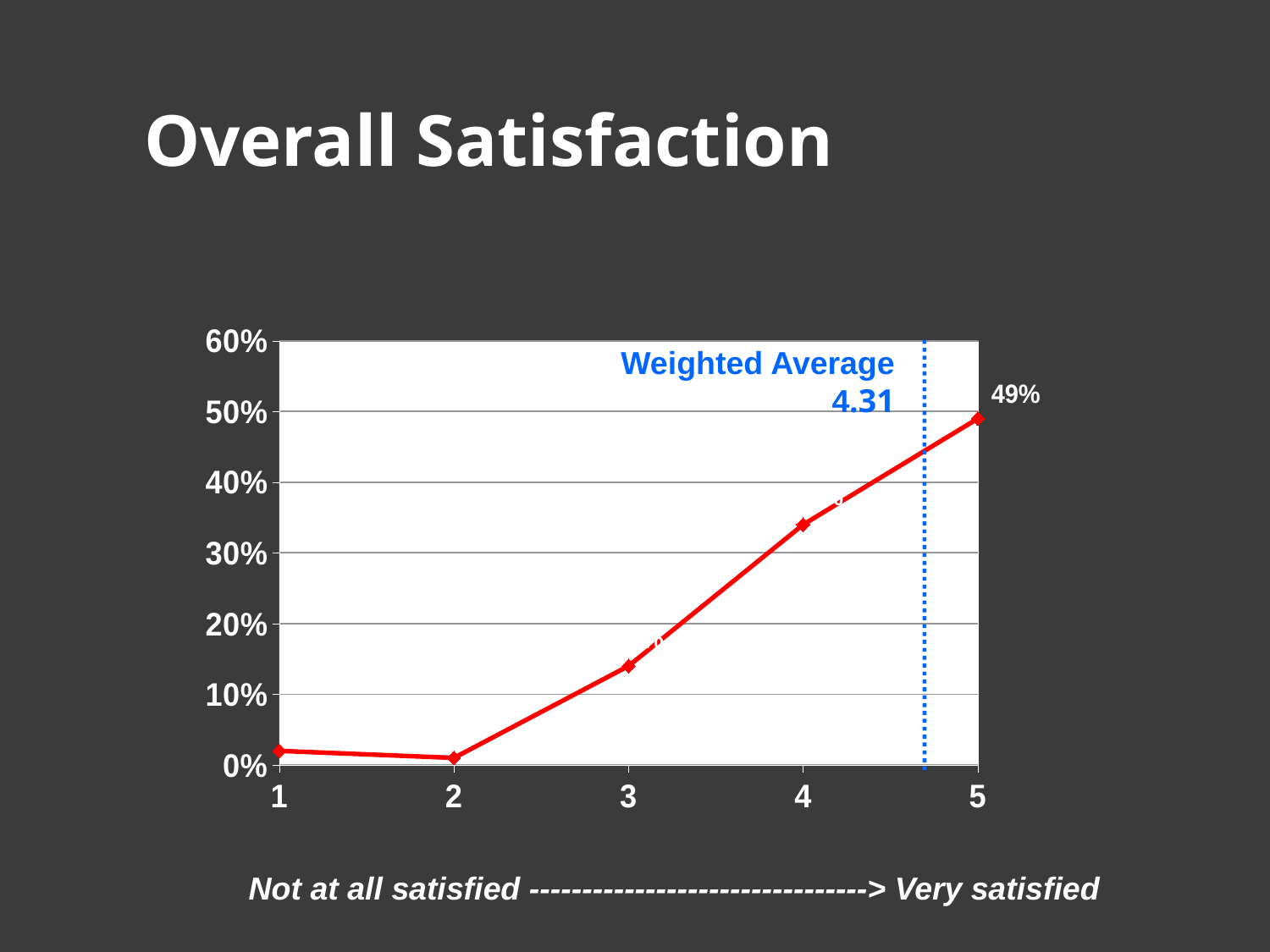
What is the title of the slide? Overall Satisfaction Is the value for category 3 greater or less than 20%? less Do the values generally rise or fall from category 2 to category 5? rise What is the value for category 5? 49% Which has a larger value, category 3 or category 4? 4 Which category has the highest value? 5 What weighted average is shown on the chart? 4.31 How many data points are plotted on the chart? 5 Is the value for category 4 greater or less than 40%? less Is the value for category 2 greater or less than 10%? less What kind of chart is shown on the slide? line chart